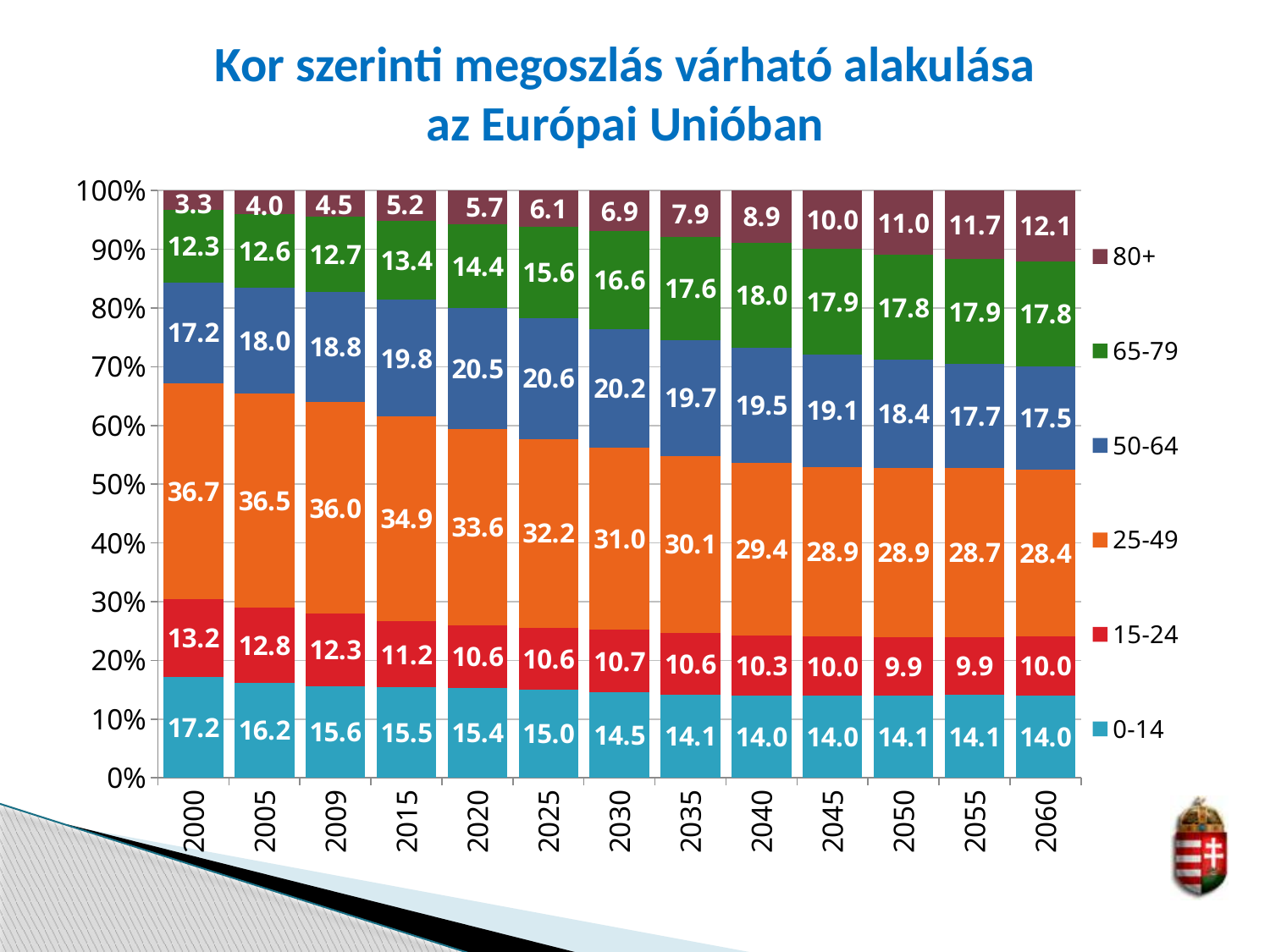
Which is larger, the 50-64 value in 2025 or in 2000? 2025 What is the value for the 80+ series in 2060? 12.1 By how much does the 80+ value in 2060 exceed the 80+ value in 2000? 8.8 In which year is the 80+ series highest? 2060 How many years are shown on the x axis? 13 What kind of chart is shown on the slide? Stacked bar chart In which year is the 25-49 series lowest? 2060 What is the difference between the 0-14 value in 2000 and in 2060? 3.2 What is the value for the 0-14 series in 2030? 14.5 Does the 80+ series rise or fall from 2000 to 2060? Rise How many series does the legend list? 6 What is the value for the 25-49 series in 2000? 36.7